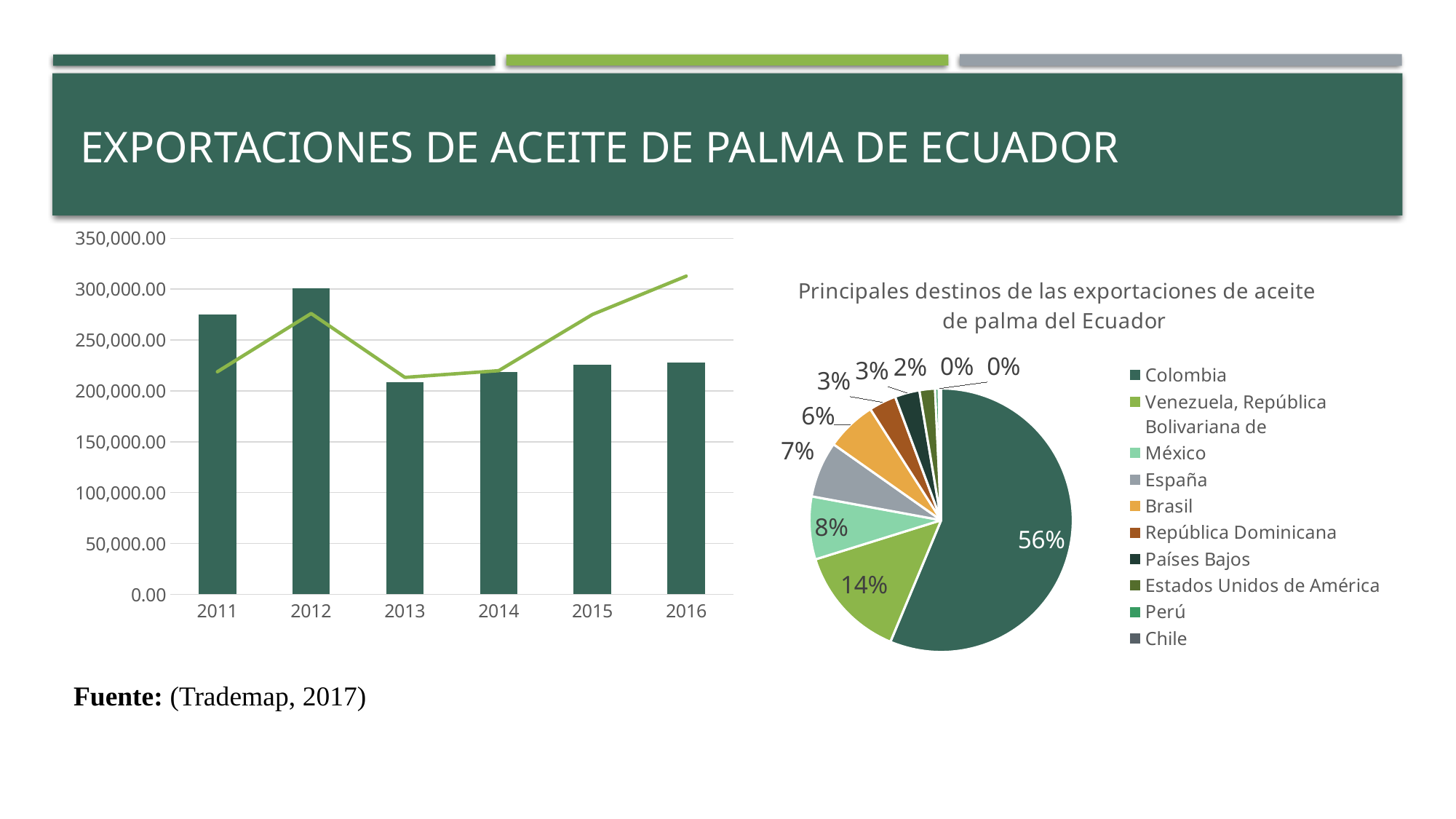
In the bar chart on the left, is the bar for 2012 greater or less than 250,000.00? greater In the bar chart on the left, which year has the shortest bar? 2013 How many years are shown on the x axis of the bar chart on the left? 6 In the pie chart 'Principales destinos de las exportaciones de aceite de palma del Ecuador', what share does Venezuela, República Bolivariana de have? 14% In the pie chart 'Principales destinos de las exportaciones de aceite de palma del Ecuador', how many percentage points larger is Colombia's share than Venezuela's? 42 In the bar chart on the left, is the bar for 2013 greater or less than 250,000.00? less What kind of chart is on the left of the slide? A bar chart with a line overlaid In the pie chart 'Principales destinos de las exportaciones de aceite de palma del Ecuador', what share does Colombia have? 56% In the bar chart on the left, which year has the tallest bar? 2012 In the pie chart 'Principales destinos de las exportaciones de aceite de palma del Ecuador', which destination has the largest slice? Colombia How many destinations does the legend of the pie chart 'Principales destinos de las exportaciones de aceite de palma del Ecuador' list? 10 In the bar chart on the left, is the bar for 2011 greater or less than 250,000.00? greater